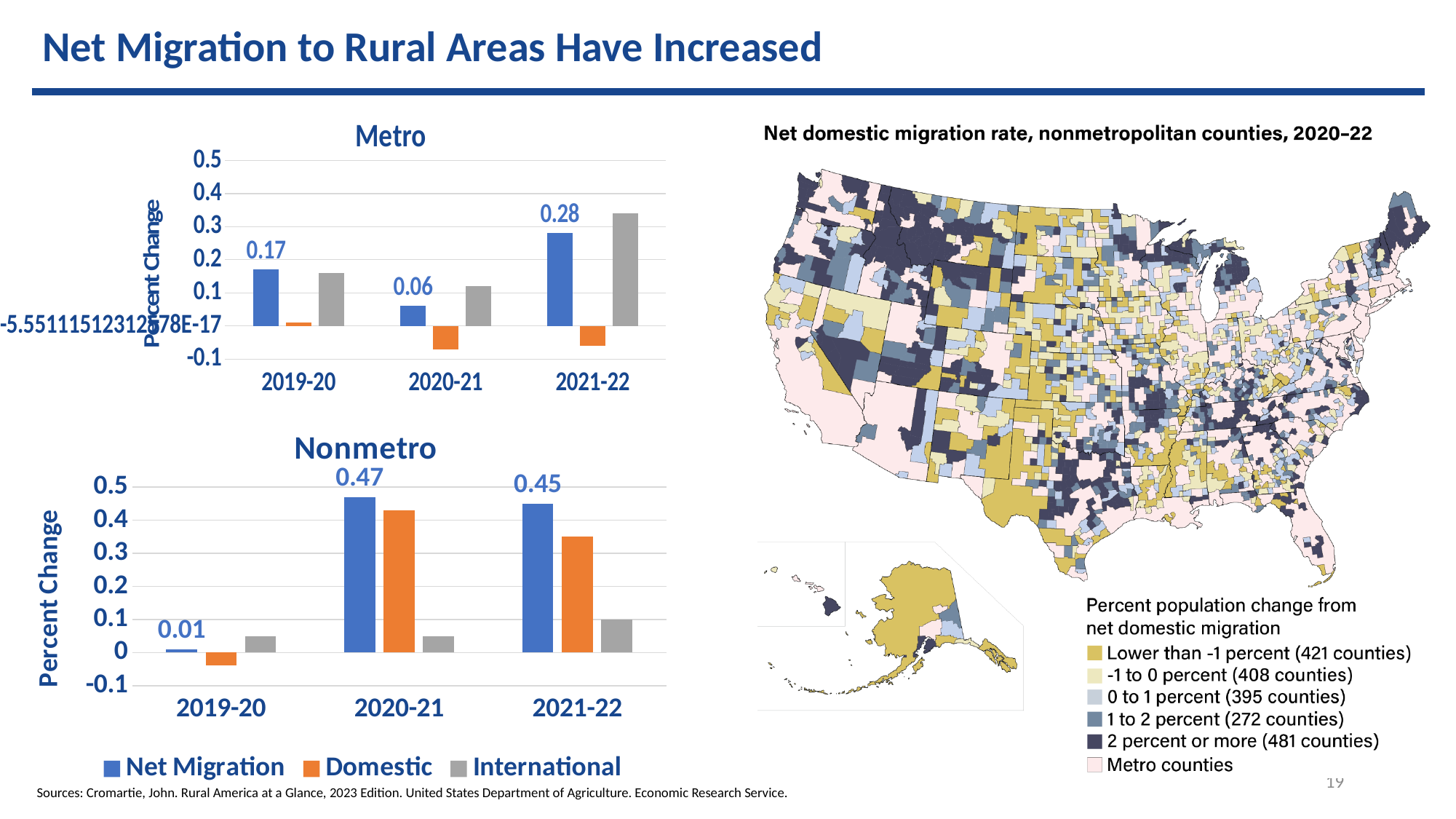
In the Nonmetro chart, is the Net Migration value larger in 2020-21 or 2021-22? 2020-21 In the Nonmetro chart, which year has the lowest Net Migration value? 2019-20 In the Metro chart, which year has the highest Net Migration value? 2021-22 In the Nonmetro chart, what is the difference between the Net Migration values for 2020-21 and 2019-20? 0.46 In the Nonmetro chart, what is the Net Migration value for 2020-21? 0.47 In the Metro chart, what is the Net Migration value for 2021-22? 0.28 In the Metro chart, is the International value for 2021-22 greater or less than 0.3? greater How many series does the legend at the bottom of the slide list? 3 What kind of chart is the Nonmetro chart? bar chart In the Nonmetro chart, is the Domestic value for 2020-21 greater or less than 0.4? greater In the Metro chart, what is the difference between the Net Migration values for 2021-22 and 2020-21? 0.22 In the Metro chart, which year has the lowest Net Migration value? 2020-21